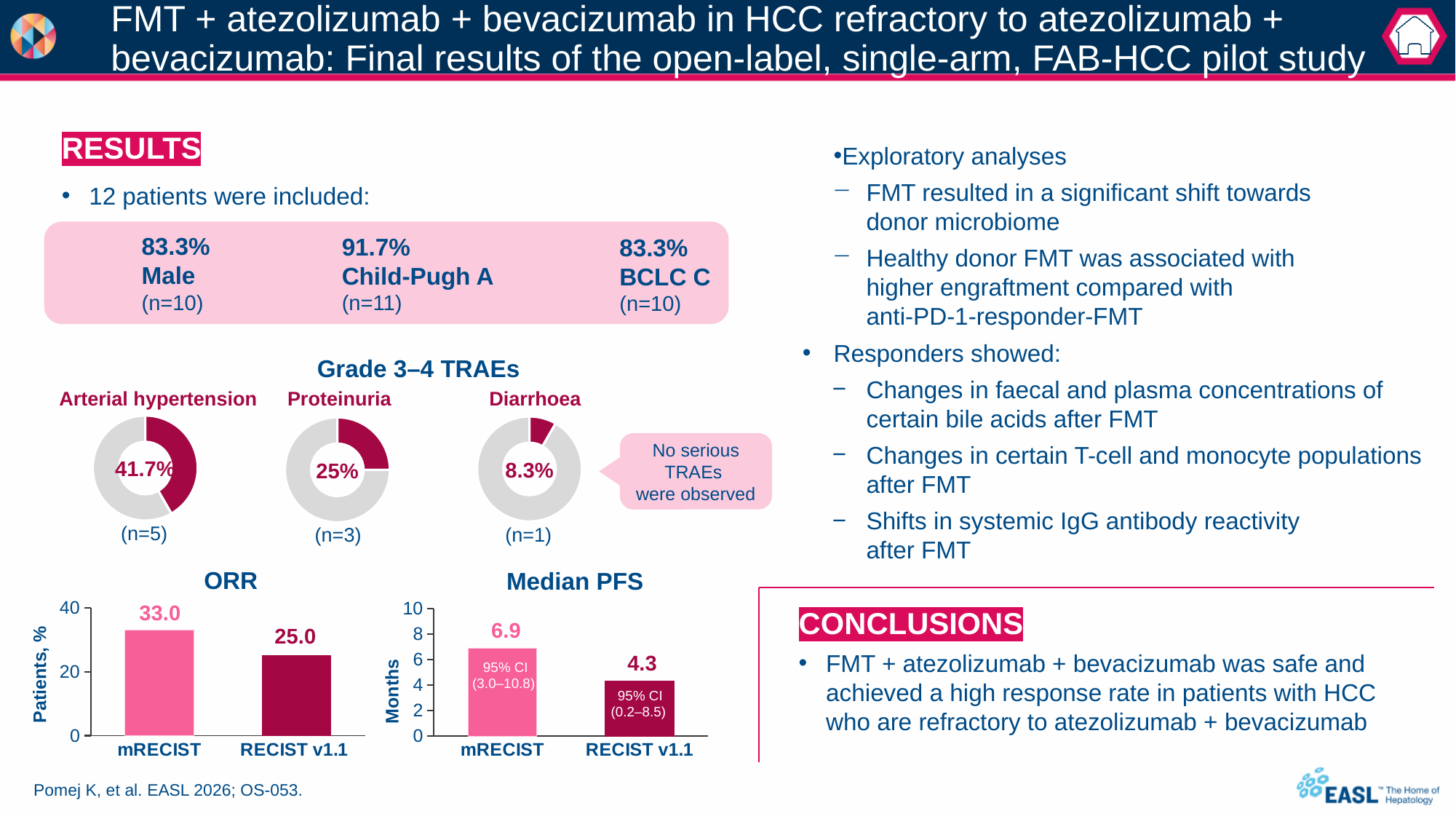
In the Median PFS chart, what is the value for RECIST v1.1? 4.3 In the Grade 3–4 TRAEs donut charts, what percentage is shown for Proteinuria? 25% In the Median PFS chart, what is the value for mRECIST? 6.9 Among the Grade 3–4 TRAEs donut charts, which adverse event has the highest percentage? Arterial hypertension In the ORR chart, is the value for RECIST v1.1 greater or less than 20? greater In the ORR chart, what is the difference between the mRECIST and RECIST v1.1 values? 8.0 In the ORR chart, what is the value for mRECIST? 33.0 What kind of chart is the ORR chart? bar chart In the Median PFS chart, which category has the higher value, mRECIST or RECIST v1.1? mRECIST In the ORR chart, what is the value for RECIST v1.1? 25.0 In the Median PFS chart, what is the difference between the mRECIST and RECIST v1.1 values? 2.6 How many categories are shown on the x axis of the Median PFS chart? 2